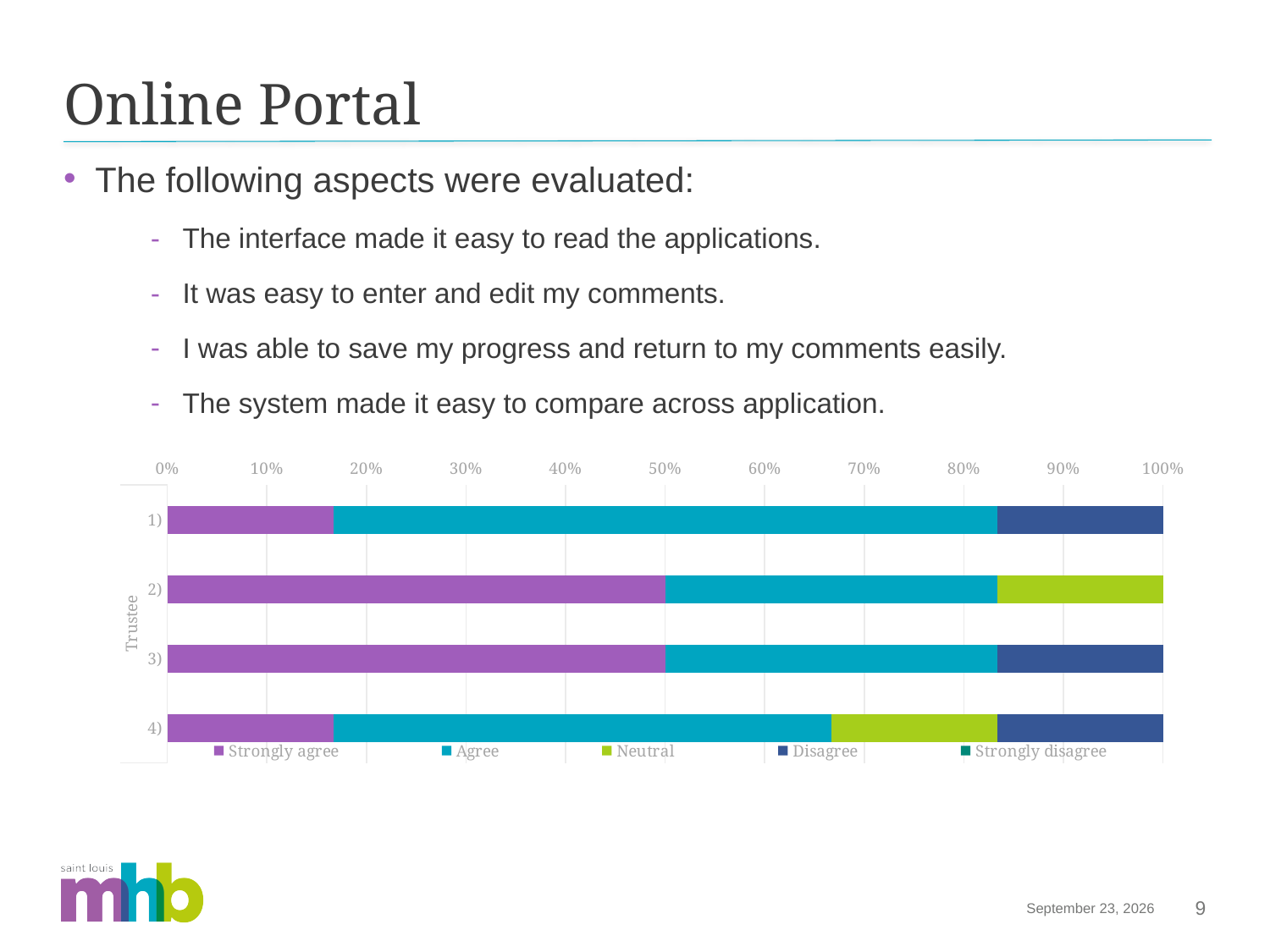
Is the Strongly agree share for trustee 1) greater or less than 20%? less Which has the larger Strongly agree share, trustee 1) or trustee 2)? 2) How many series does the chart legend list? 5 Which trustee has the largest Agree segment? 1) How many categories (trustees) are plotted on the chart? 4 Is the Strongly agree share for trustee 2) greater or less than 40%? greater Which has the larger Agree share, trustee 1) or trustee 3)? 1) What kind of chart is shown on the slide? Stacked bar chart What is the title of the vertical axis of the chart? Trustee Is the Agree share for trustee 4) greater or less than 40%? greater Which series is shown in purple in the chart? Strongly agree